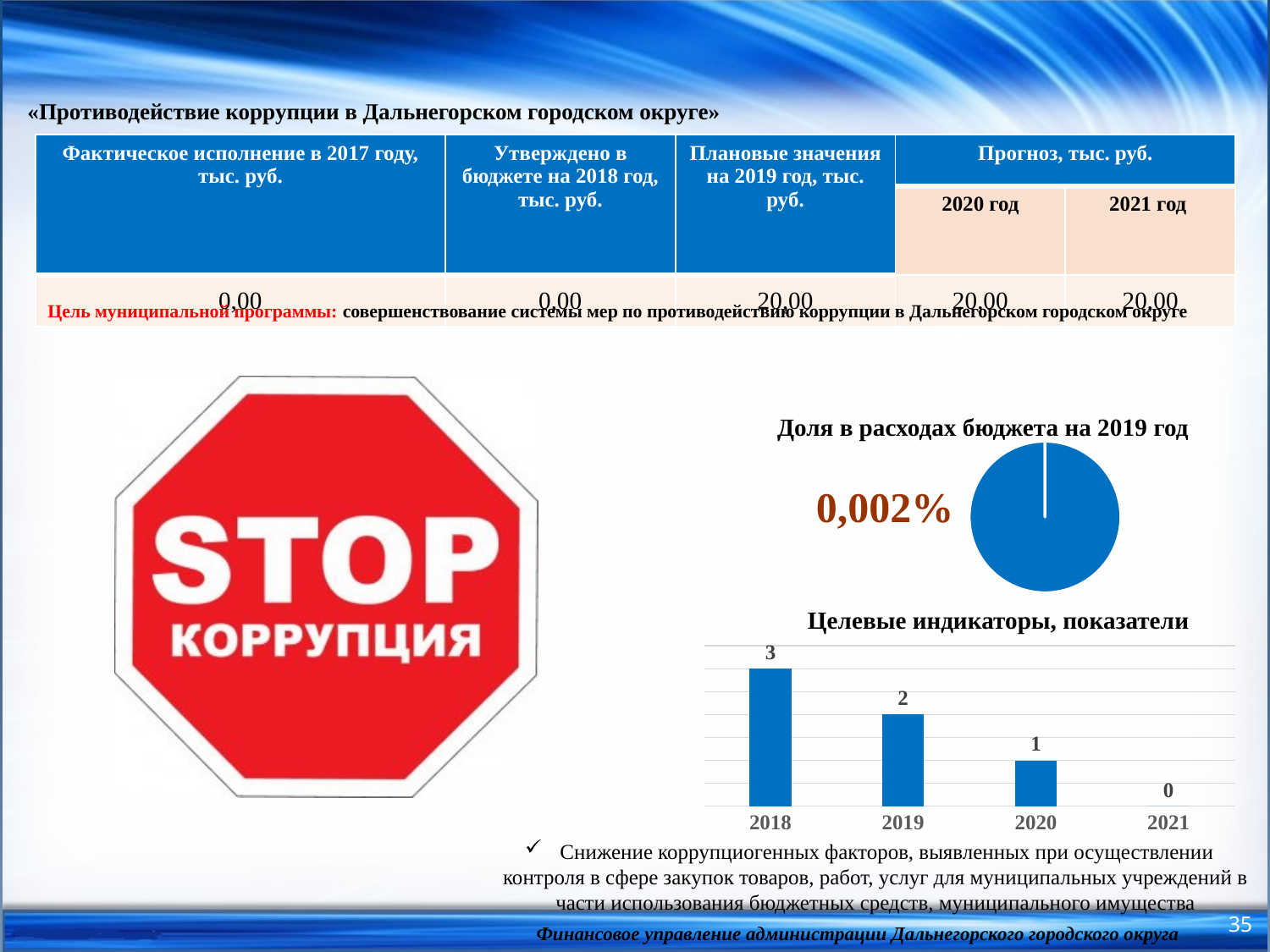
What kind of chart is the one titled "Целевые индикаторы, показатели"? bar chart In the chart titled "Целевые индикаторы, показатели", what is the difference between the values for 2018 and 2020? 2 In the chart titled "Целевые индикаторы, показатели", what is the value for 2019? 2 In the chart titled "Целевые индикаторы, показатели", what is the value for 2020? 1 In the chart titled "Целевые индикаторы, показатели", which year has the lowest value? 2021 In the chart titled "Целевые индикаторы, показатели", which is larger, the value for 2019 or the value for 2020? 2019 In the chart titled "Целевые индикаторы, показатели", what is the value for 2018? 3 What kind of chart is the one titled "Доля в расходах бюджета на 2019 год"? pie chart In the chart titled "Целевые индикаторы, показатели", what is the value for 2021? 0 In the chart titled "Целевые индикаторы, показатели", do the values rise or fall from 2018 to 2021? fall In the chart titled "Целевые индикаторы, показатели", which year has the highest value? 2018 How many years are shown in the chart titled "Целевые индикаторы, показатели"? 4